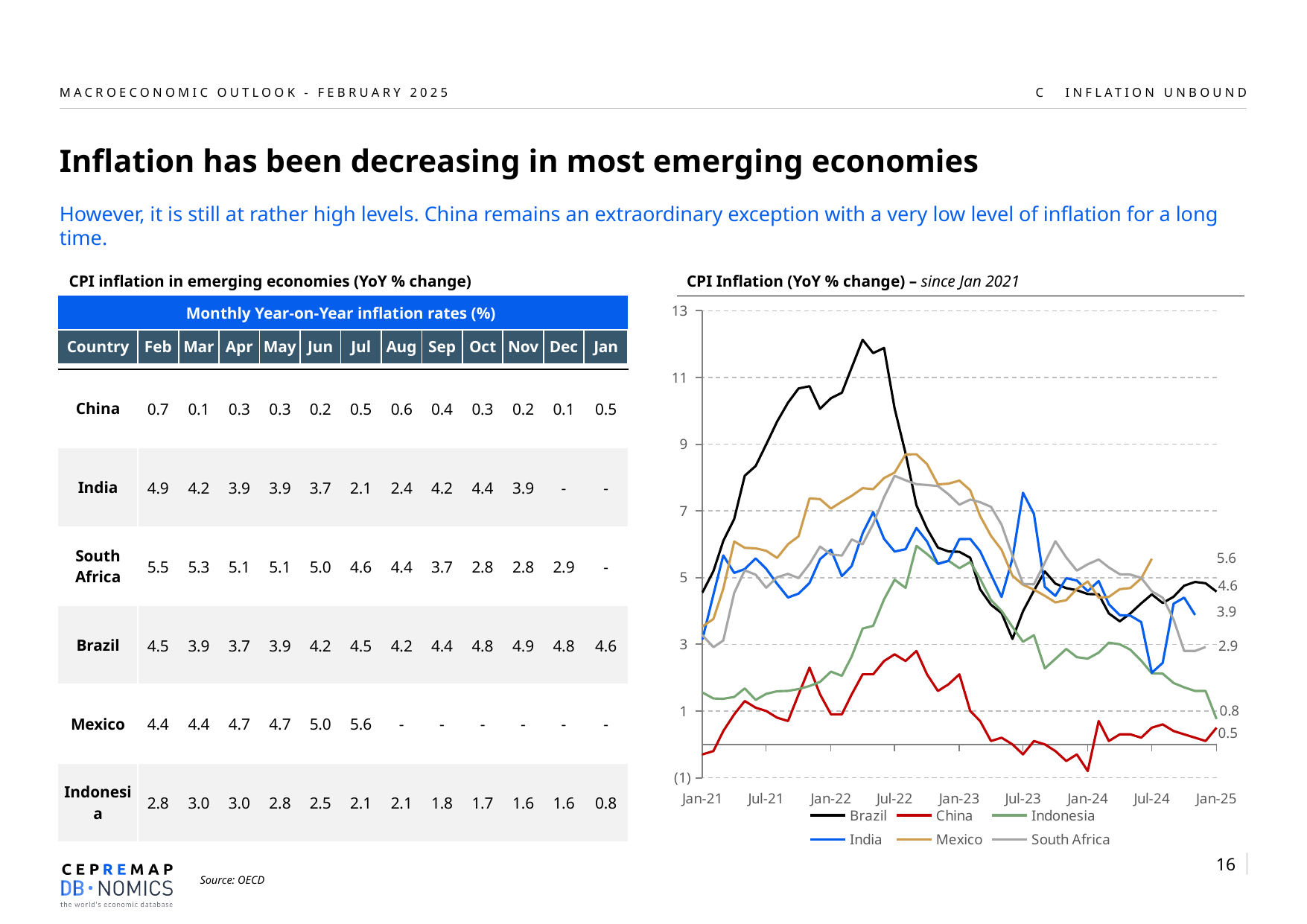
In the CPI Inflation line chart, does the Brazil line rise or fall between Jul-22 and Jul-23? fall In the CPI Inflation line chart, what is the latest labelled value for China? 0.5 How many series does the legend of the CPI Inflation line chart list? 6 In the CPI Inflation line chart, is the peak value of the Brazil line greater or less than 11? greater In the CPI Inflation line chart, what is the latest labelled value for Brazil? 4.6 In the CPI Inflation line chart, which colour is used for the China series? red What kind of chart is the 'CPI Inflation (YoY % change) – since Jan 2021' chart? line chart In the CPI Inflation line chart, which country's line reaches the highest peak over the period? Brazil In the CPI Inflation line chart, what is the difference between the latest labelled values for Brazil and China? 4.1 In the CPI Inflation line chart, what is the latest labelled value for Indonesia? 0.8 In the CPI Inflation line chart, which country has the lowest labelled end value? China In the CPI Inflation line chart, what is the latest labelled value for South Africa? 2.9